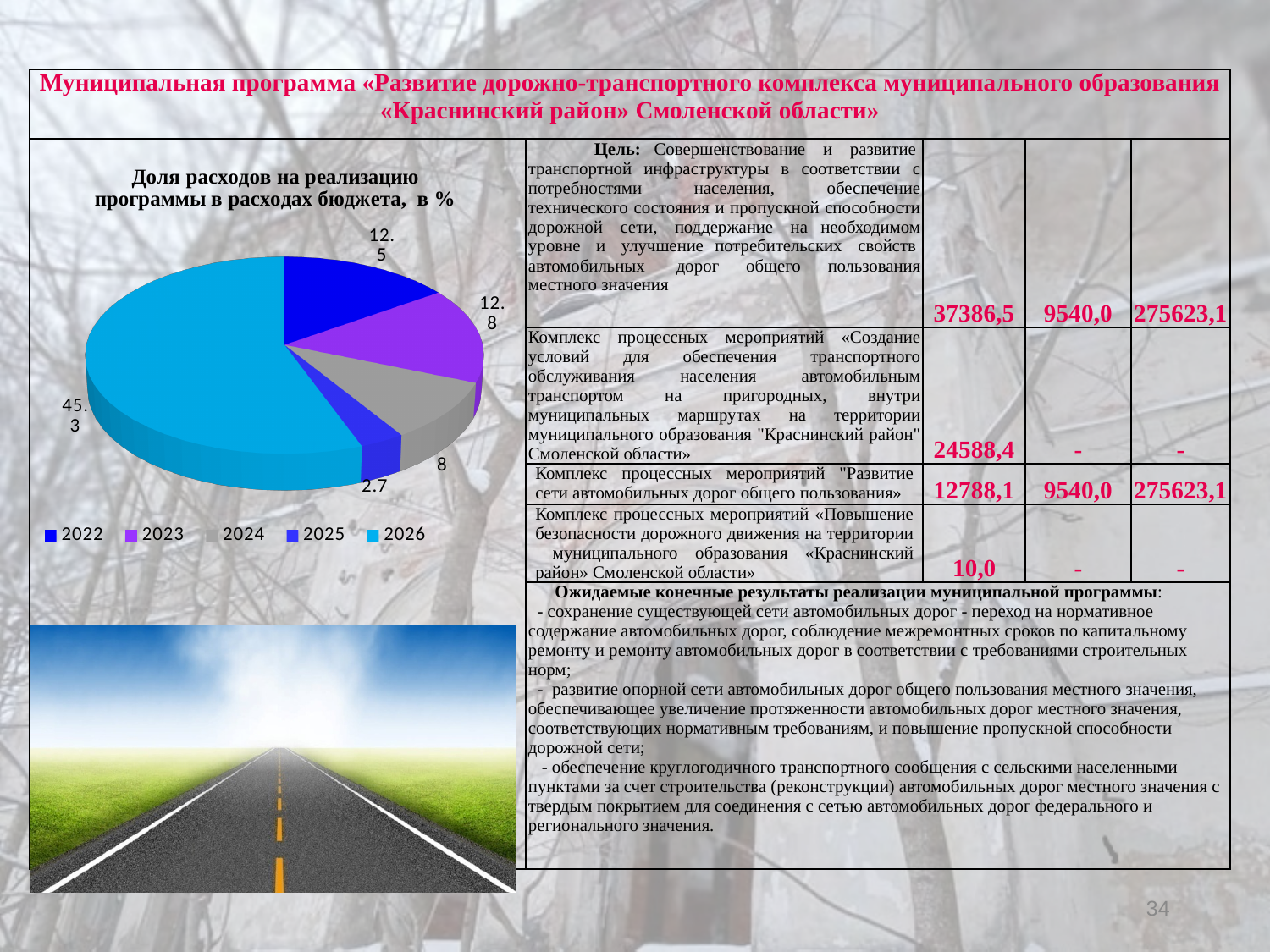
How many years does the pie chart's legend list? 5 Which year has the largest slice in the pie chart? 2026 What is the value shown for 2022 in the pie chart? 12.5 What is the difference between the values for 2023 and 2022 in the pie chart? 0.3 What is the value shown for 2025 in the pie chart? 2.7 Which is larger in the pie chart, the value for 2024 or the value for 2025? 2024 What is the title of the pie chart? Доля расходов на реализацию программы в расходах бюджета, в % What is the value shown for 2026 in the pie chart? 45.3 Which year has the smallest slice in the pie chart? 2025 What is the value shown for 2023 in the pie chart? 12.8 How many slices does the pie chart have? 5 What type of chart is shown on the slide? pie chart